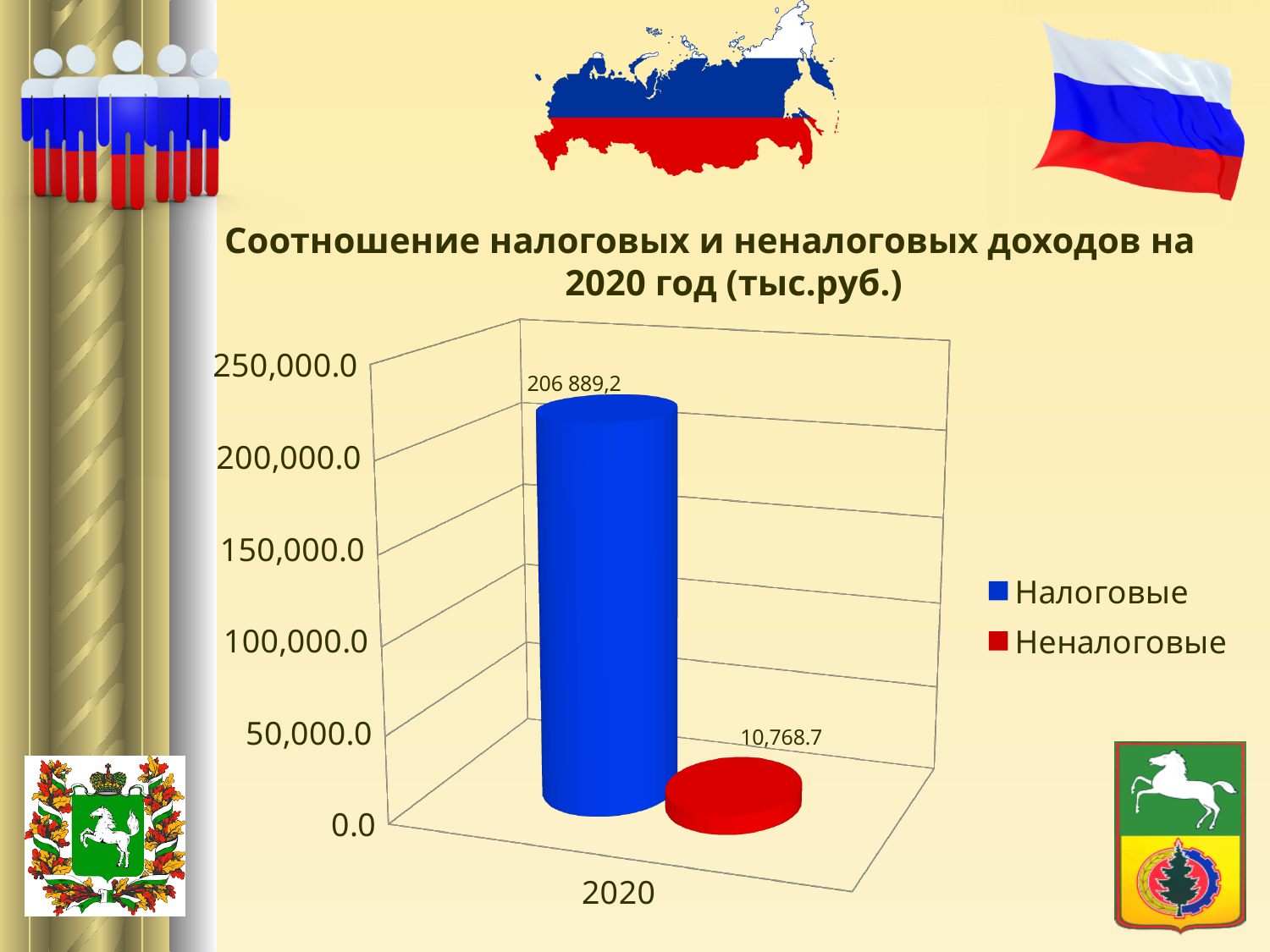
Which series has the higher value in 2020? Налоговые What is the difference between the Налоговые and Неналоговые values in 2020? 196,120.5 What colour is the bar for Неналоговые? red How many series does the legend list? 2 What is the value for Неналоговые in 2020? 10,768.7 What kind of chart is shown on the slide? bar chart Which is larger in 2020, Налоговые or Неналоговые? Налоговые Which series has the lower value in 2020? Неналоговые Is the value for Налоговые greater or less than 200,000.0? greater Is the value for Неналоговые greater or less than 50,000.0? less What is the value for Налоговые in 2020? 206 889,2 How many categories are shown on the x axis? 1